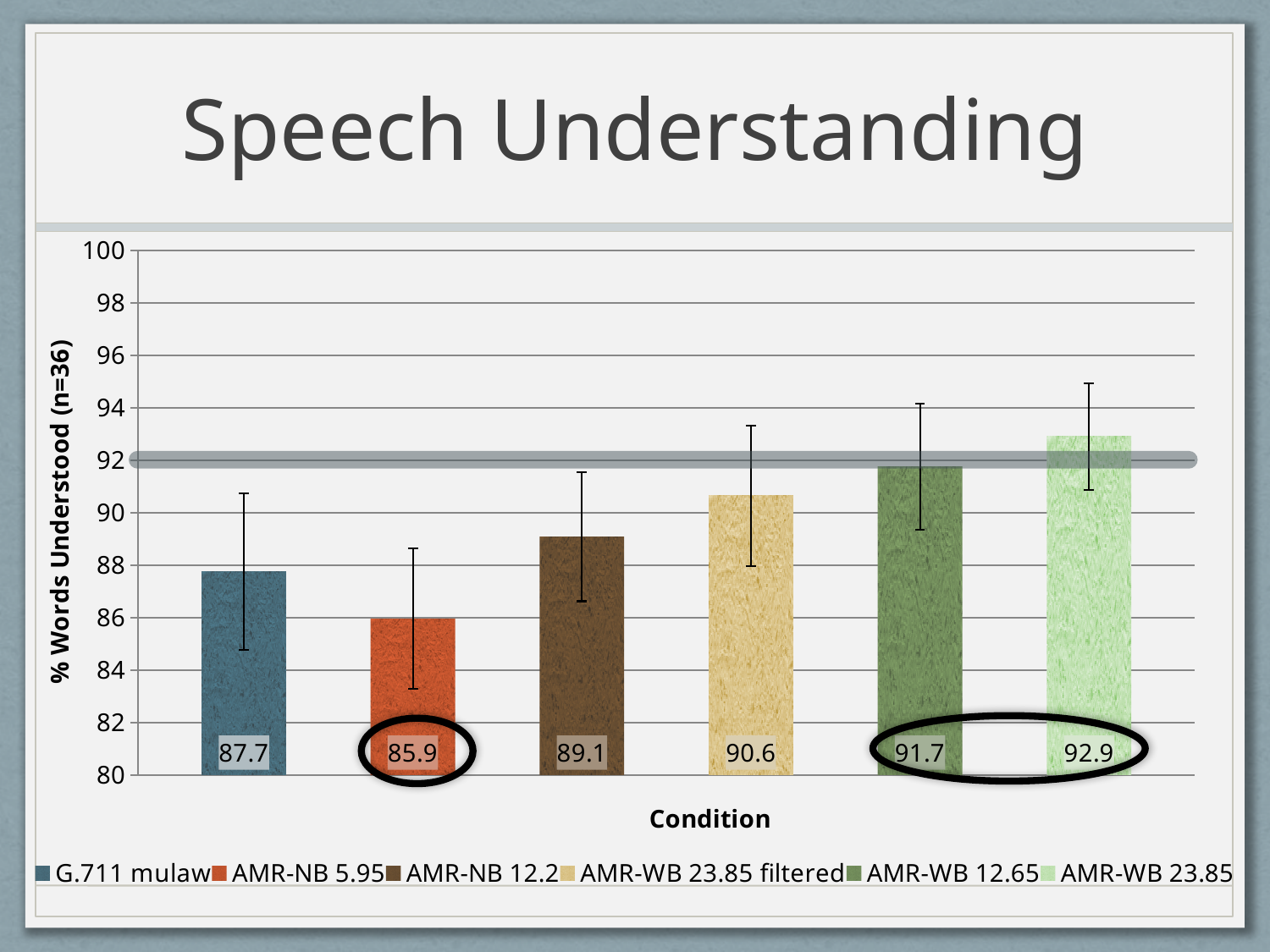
Is the value for AMR-WB 23.85 greater or less than 92? greater What is the value for AMR-WB 23.85 filtered? 90.6 What is the difference between the values for AMR-WB 23.85 and AMR-NB 5.95? 7.0 Which condition has the highest % words understood? AMR-WB 23.85 Which is larger, the value for AMR-WB 12.65 or the value for AMR-NB 12.2? AMR-WB 12.65 What is the value for AMR-NB 5.95? 85.9 What is the difference between the values for AMR-NB 12.2 and G.711 mulaw? 1.4 What is the value for G.711 mulaw? 87.7 What kind of chart is shown on the slide? bar chart How many conditions are plotted in the chart? 6 How many entries does the legend list? 6 Which condition has the lowest % words understood? AMR-NB 5.95